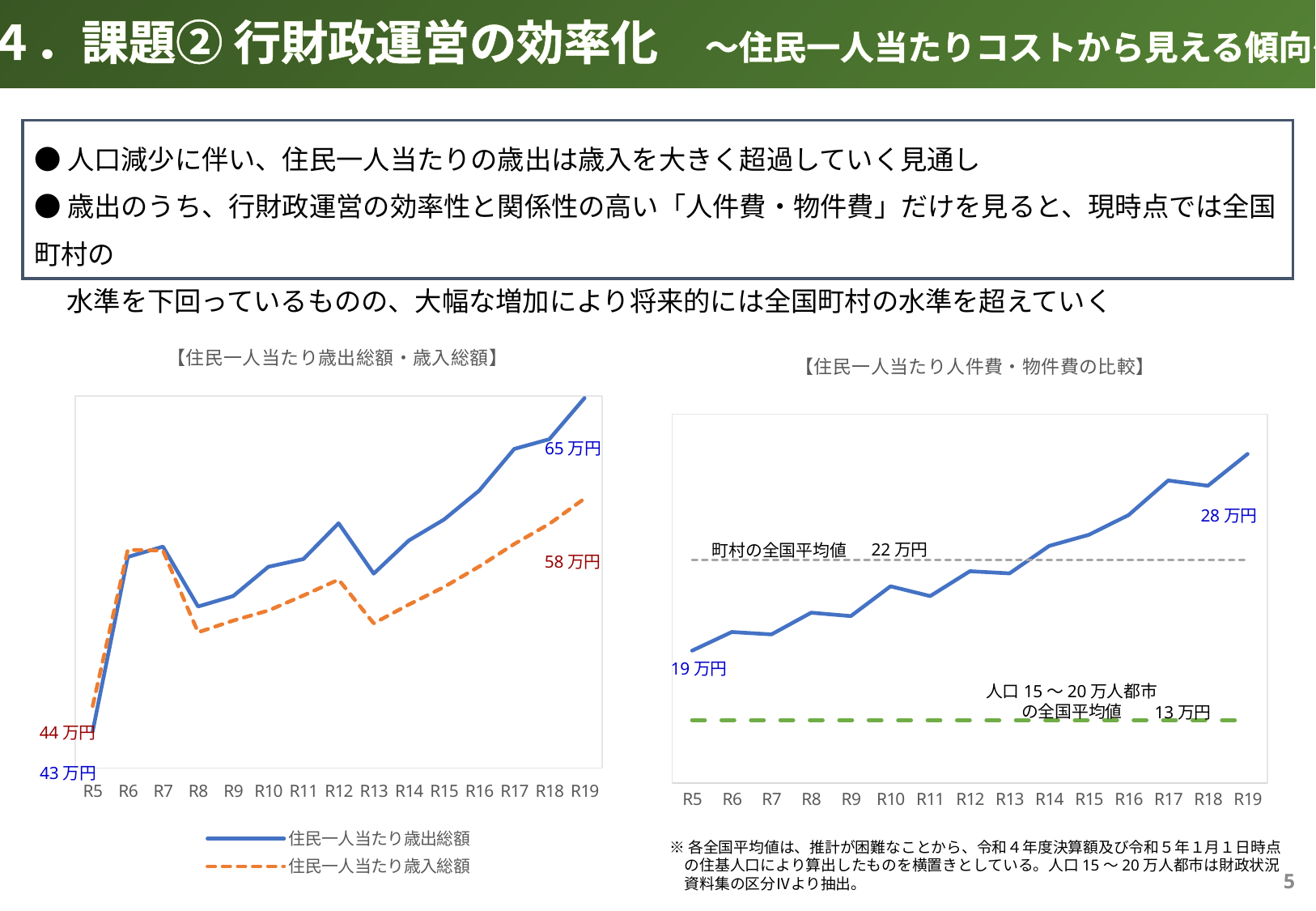
What kind of chart is the left chart titled 【住民一人当たり歳出総額・歳入総額】? Line chart In the left chart 【住民一人当たり歳出総額・歳入総額】, what is the difference between the end labels of 歳出総額 (65万円) and 歳入総額 (58万円)? 7万円 In the right chart 【住民一人当たり人件費・物件費の比較】, what is the labelled value at R19? 28万円 In the right chart 【住民一人当たり人件費・物件費の比較】, what is the value of the 町村の全国平均値 reference line? 22万円 In the left chart 【住民一人当たり歳出総額・歳入総額】, what is the labelled value of 住民一人当たり歳出総額 at R5? 43万円 In the right chart 【住民一人当たり人件費・物件費の比較】, what is the value of the 人口15～20万人都市の全国平均値 reference line? 13万円 In the left chart 【住民一人当たり歳出総額・歳入総額】, how many fiscal years are shown on the x axis? 15 In the left chart 【住民一人当たり歳出総額・歳入総額】, what is the labelled value at the end of the 住民一人当たり歳出総額 line? 65万円 In the left chart 【住民一人当たり歳出総額・歳入総額】, how many series does the legend list? 2 In the right chart 【住民一人当たり人件費・物件費の比較】, what is the labelled value at R5? 19万円 In the left chart 【住民一人当たり歳出総額・歳入総額】, what is the labelled value of 住民一人当たり歳入総額 at R5? 44万円 In the left chart 【住民一人当たり歳出総額・歳入総額】, what is the labelled value at the end of the 住民一人当たり歳入総額 line? 58万円